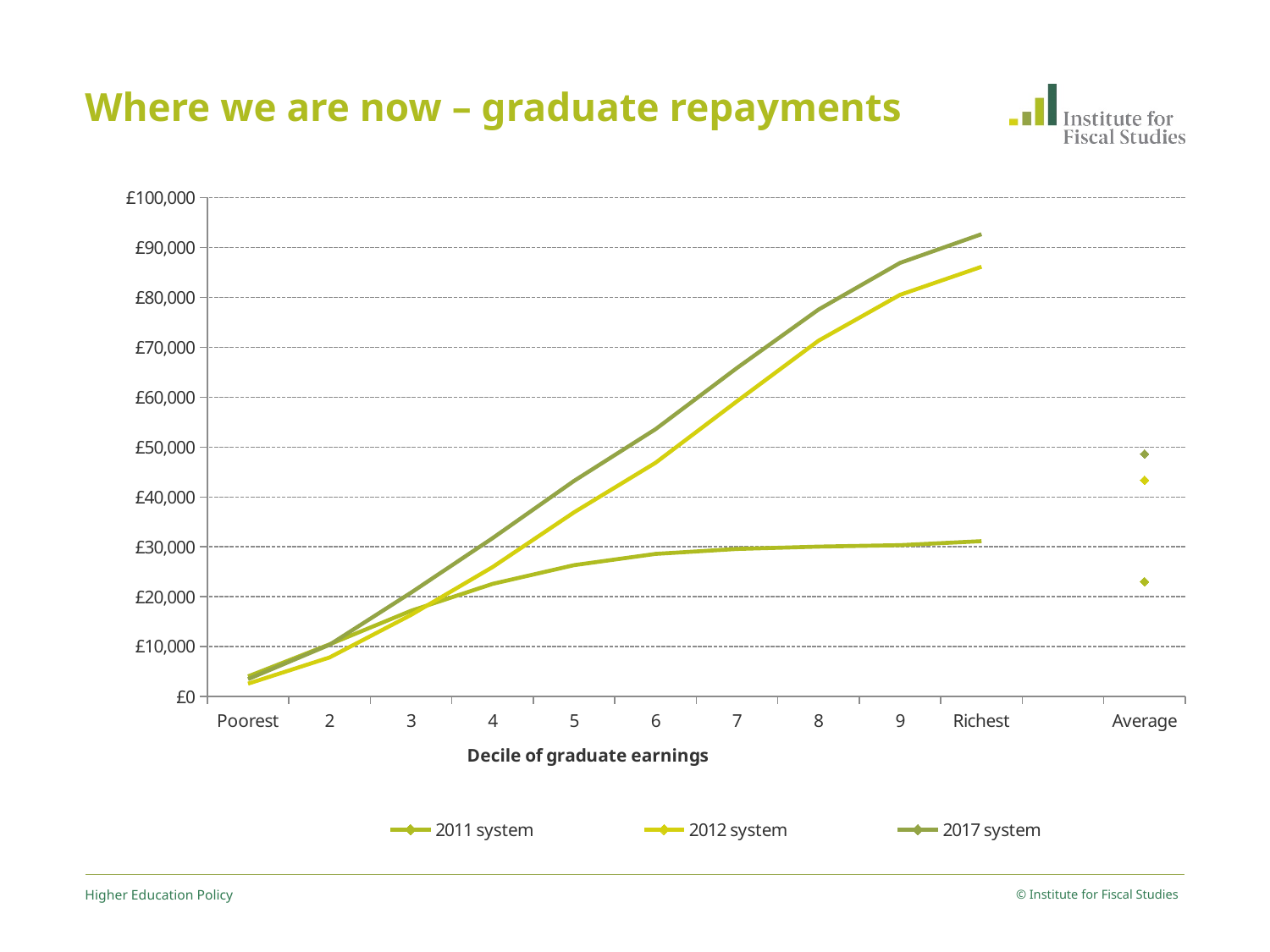
Which system has the lowest value at Average? 2011 system Is the value for the 2012 system at decile 5 greater or less than £30,000? greater At decile 6, which is larger: the 2011 system or the 2012 system? 2012 system What kind of chart is shown on the slide? Line chart Is the value for the 2017 system at Richest greater or less than £80,000? greater At Richest, which is larger: the 2017 system or the 2012 system? 2017 system Does the 2017 system line rise or fall from Poorest to Richest? Rises What is the title of the x axis? Decile of graduate earnings Is the value for the 2011 system at Richest greater or less than £40,000? less How many series does the legend list? 3 What are the three series named in the legend? 2011 system, 2012 system, 2017 system